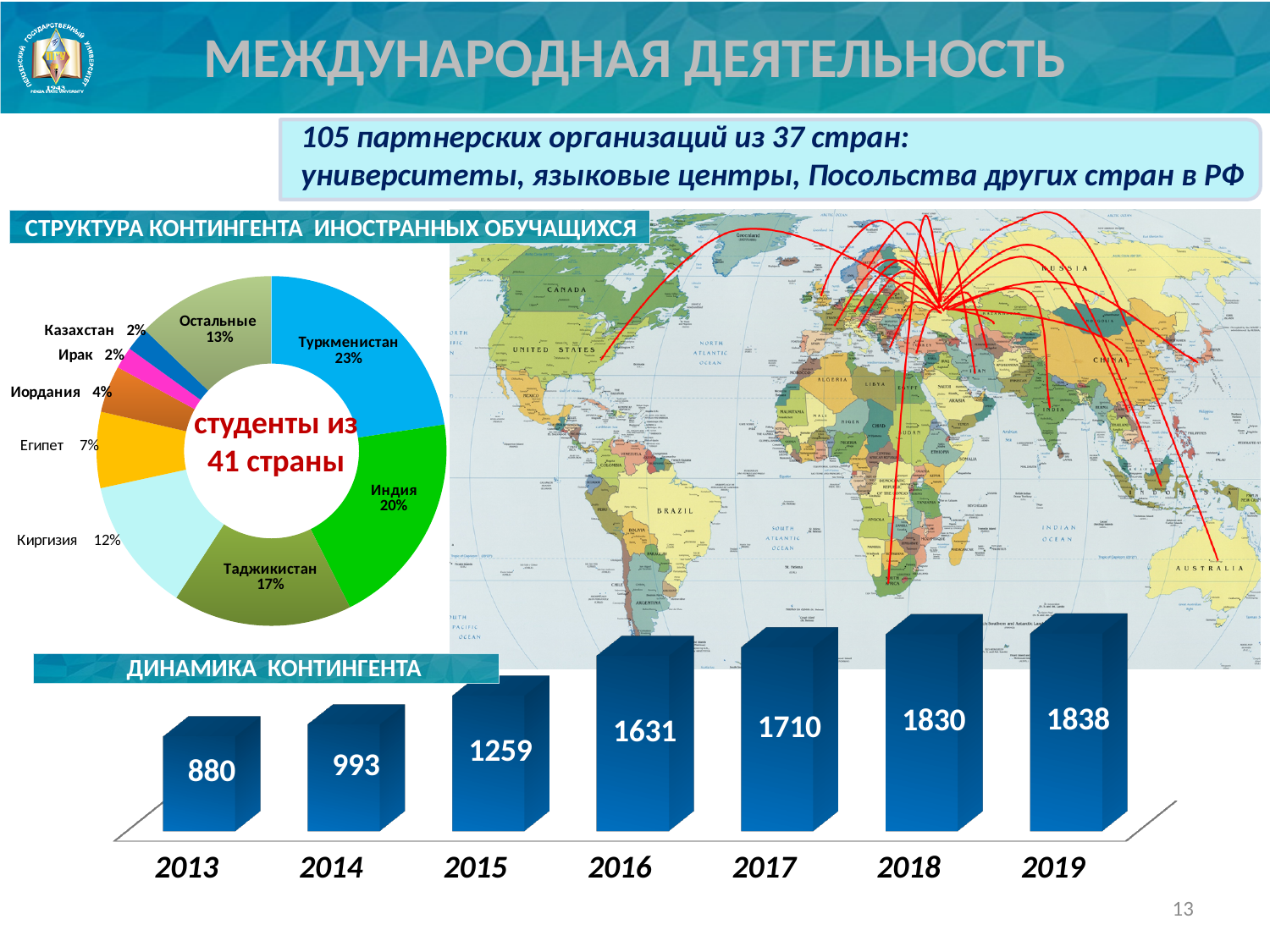
In the 'ДИНАМИКА КОНТИНГЕНТА' chart, how many years are shown? 7 In the 'ДИНАМИКА КОНТИНГЕНТА' chart, which year has the highest value? 2019 In the 'ДИНАМИКА КОНТИНГЕНТА' chart, what is the value for 2013? 880 In the 'СТРУКТУРА КОНТИНГЕНТА ИНОСТРАННЫХ ОБУЧАЩИХСЯ' chart, what share does Киргизия have? 12% What kind of chart is 'ДИНАМИКА КОНТИНГЕНТА'? bar chart In the 'СТРУКТУРА КОНТИНГЕНТА ИНОСТРАННЫХ ОБУЧАЩИХСЯ' chart, which is larger, the share for Индия or the share for Таджикистан? Индия In the 'ДИНАМИКА КОНТИНГЕНТА' chart, what is the value for 2016? 1631 In the 'ДИНАМИКА КОНТИНГЕНТА' chart, which year has the lowest value? 2013 In the 'ДИНАМИКА КОНТИНГЕНТА' chart, what is the difference between the values for 2015 and 2014? 266 In the 'СТРУКТУРА КОНТИНГЕНТА ИНОСТРАННЫХ ОБУЧАЩИХСЯ' chart, which country has the largest share? Туркменистан In the 'ДИНАМИКА КОНТИНГЕНТА' chart, do the values rise or fall from 2013 to 2019? rise In the 'СТРУКТУРА КОНТИНГЕНТА ИНОСТРАННЫХ ОБУЧАЩИХСЯ' chart, what share does Туркменистан have? 23%